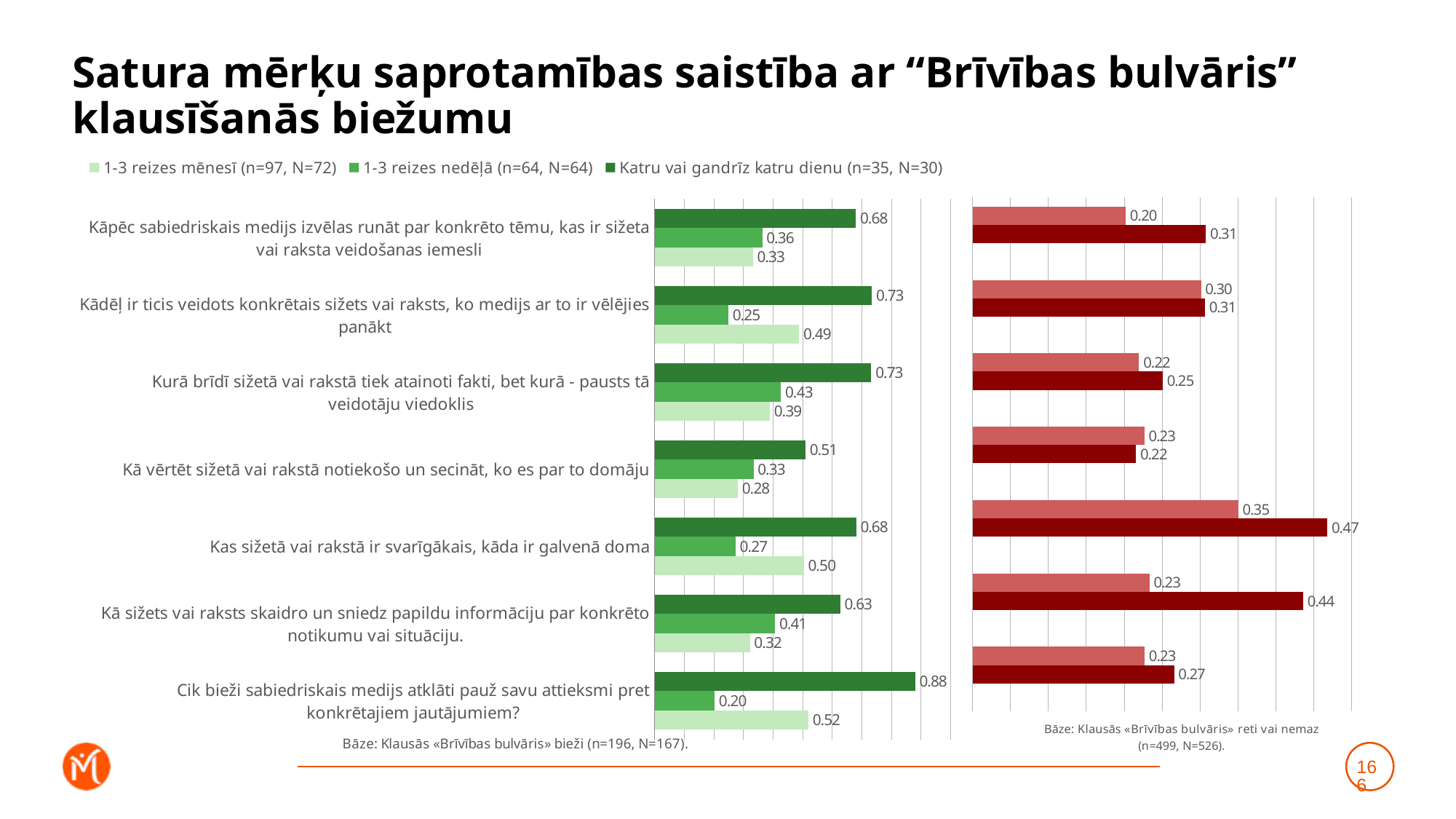
In the left (green) chart, for 'Kādēļ ir ticis veidots konkrētais sižets vai raksts, ko medijs ar to ir vēlējies panākt', what is the difference between the 'Katru vai gandrīz katru dienu' value and the '1-3 reizes nedēļā' value? 0.48 In the right (red) chart, what is the value of the darker red bar for 'Kas sižetā vai rakstā ir svarīgākais, kāda ir galvenā doma'? 0.47 In the left (green) chart, for 'Kā vērtēt sižetā vai rakstā notiekošo un secināt, ko es par to domāju', which is larger: '1-3 reizes mēnesī' or '1-3 reizes nedēļā'? 1-3 reizes nedēļā In the left (green) chart, which category has the lowest value for '1-3 reizes nedēļā'? Cik bieži sabiedriskais medijs atklāti pauž savu attieksmi pret konkrētajiem jautājumiem? In the left (green) chart, what is the value for '1-3 reizes mēnesī' for 'Kas sižetā vai rakstā ir svarīgākais, kāda ir galvenā doma'? 0.50 How many series does the legend of the left (green) chart list? 3 In the left (green) chart, what is the value for '1-3 reizes nedēļā' for 'Kurā brīdī sižetā vai rakstā tiek atainoti fakti, bet kurā - pausts tā veidotāju viedoklis'? 0.43 How many categories (statements) are shown in the left (green) chart? 7 In the left (green) chart, what is the value for 'Katru vai gandrīz katru dienu' for 'Cik bieži sabiedriskais medijs atklāti pauž savu attieksmi pret konkrētajiem jautājumiem?'? 0.88 What type of chart is used on this slide? Bar chart According to the note under the left (green) chart, what is the base for that chart? Klausās «Brīvības bulvāris» bieži (n=196, N=167) In the left (green) chart, which category has the highest value for 'Katru vai gandrīz katru dienu'? Cik bieži sabiedriskais medijs atklāti pauž savu attieksmi pret konkrētajiem jautājumiem?